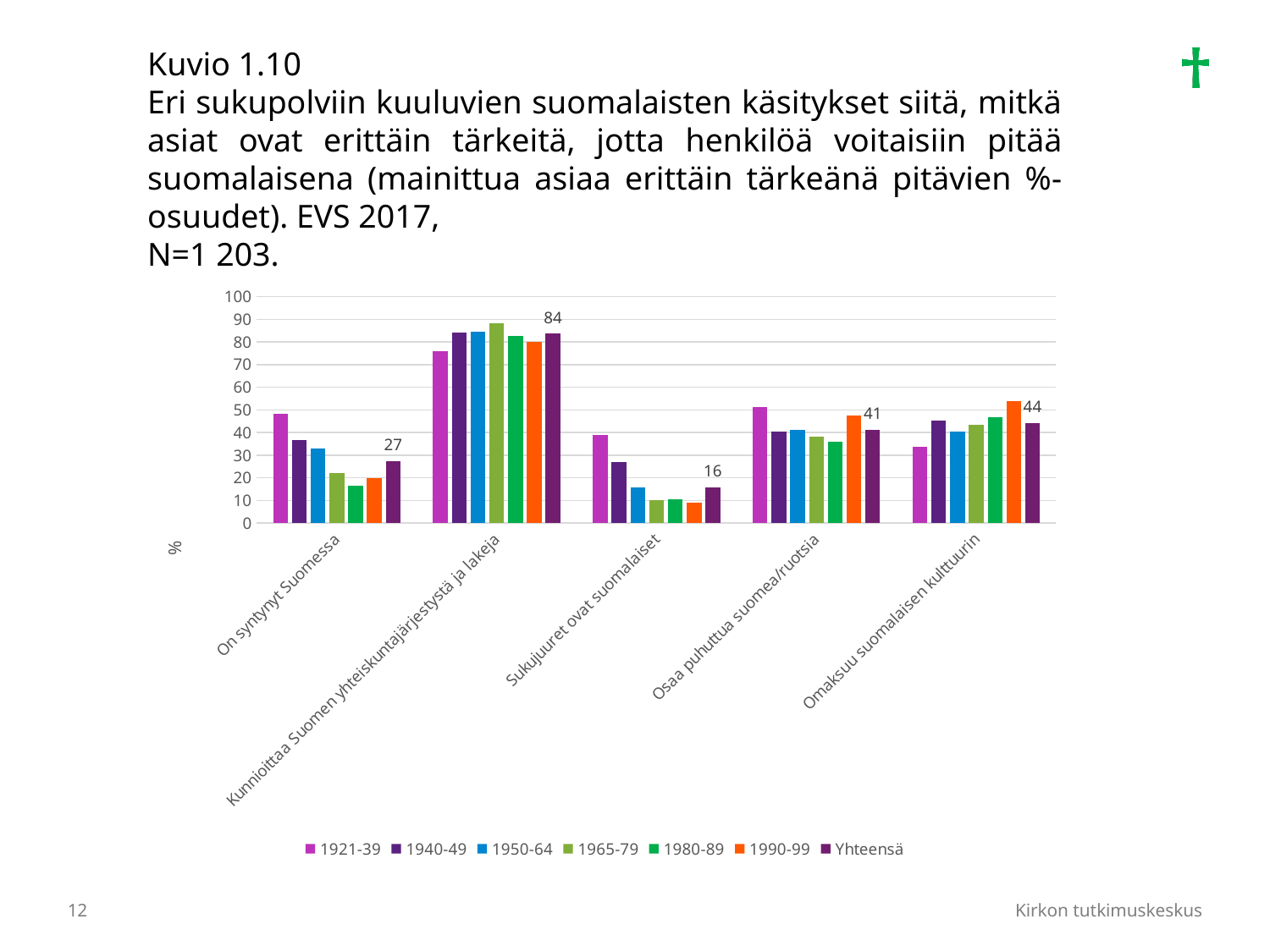
Which has the larger Yhteensä value: "Osaa puhuttua suomea/ruotsia" or "Omaksuu suomalaisen kulttuurin"? Omaksuu suomalaisen kulttuurin How many categories are shown on the x axis? 5 Is the value for the 1921-39 series in "On syntynyt Suomessa" greater or less than 40? greater Which category has the lowest Yhteensä value? Sukujuuret ovat suomalaiset What kind of chart is shown on the slide? bar chart How many series does the legend list? 7 What is the Yhteensä value for "Sukujuuret ovat suomalaiset"? 16 What is the difference between the Yhteensä values for "Kunnioittaa Suomen yhteiskuntajärjestystä ja lakeja" and "Sukujuuret ovat suomalaiset"? 68 Which category has the highest Yhteensä value? Kunnioittaa Suomen yhteiskuntajärjestystä ja lakeja What is the Yhteensä value for "On syntynyt Suomessa"? 27 What is the Yhteensä value for "Omaksuu suomalaisen kulttuurin"? 44 What is the Yhteensä value for "Kunnioittaa Suomen yhteiskuntajärjestystä ja lakeja"? 84